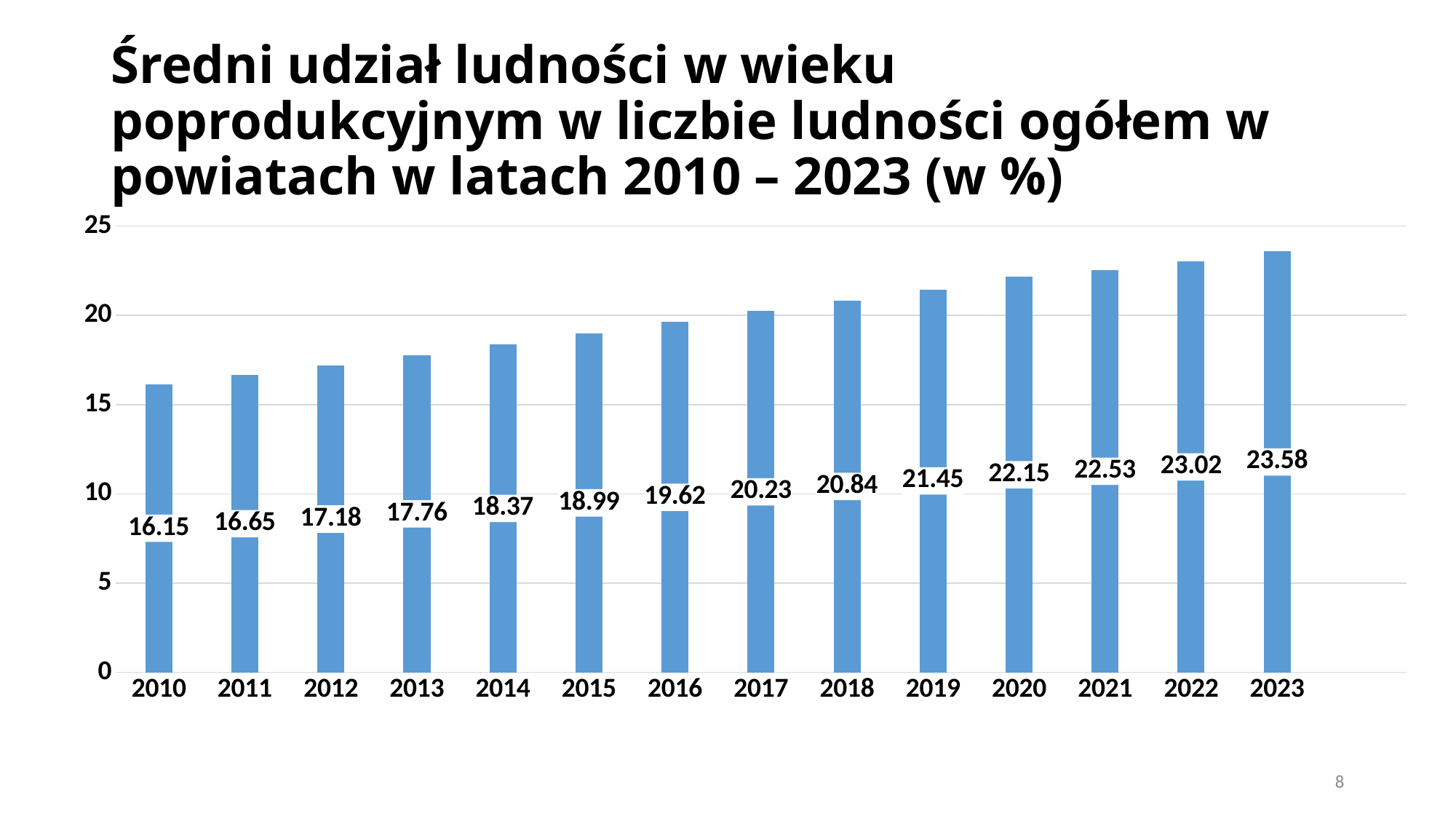
How many years are shown on the x axis? 14 What is the value for 2017? 20.23 Which year has the highest value? 2023 What is the difference between the values for 2020 and 2019? 0.70 What is the difference between the values for 2023 and 2010? 7.43 What kind of chart is this? bar chart Is the value for 2018 greater or less than 20? greater Which year has the lowest value? 2010 What is the value for 2010? 16.15 What is the value for 2023? 23.58 Which is larger, the value for 2015 or the value for 2016? 2016 Do the values rise or fall from 2010 to 2023? rise